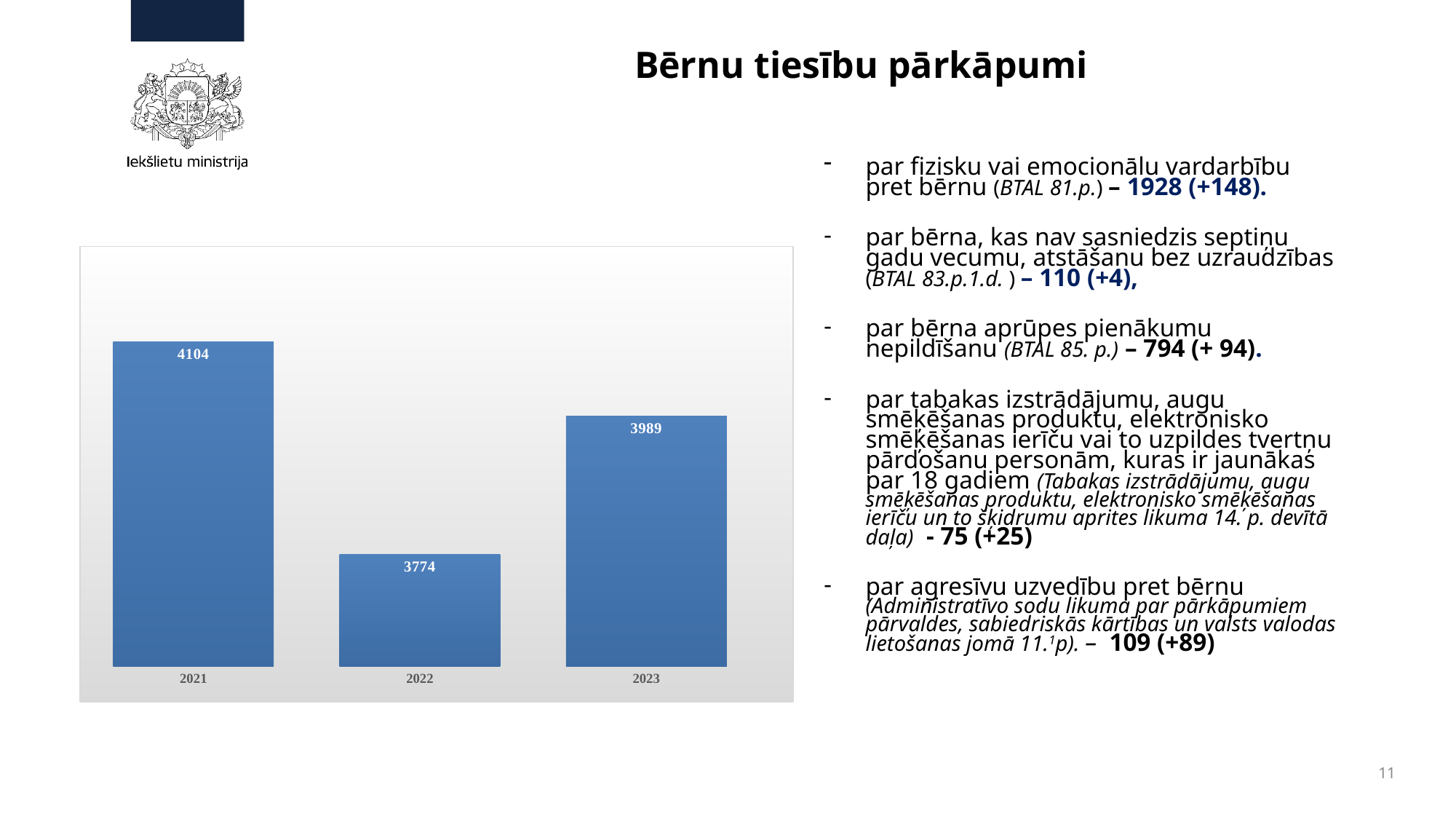
How many bars are shown in the chart? 3 Does the value rise or fall from 2021 to 2022? fall What is the difference between the values for 2021 and 2022? 330 Which year has the lowest value? 2022 What is the value for 2023? 3989 What is the difference between the values for 2023 and 2022? 215 Which year has the highest value? 2021 What kind of chart is shown on the slide? bar chart Which is larger, the value for 2021 or the value for 2023? 2021 What is the title of the slide containing the chart? Bērnu tiesību pārkāpumi What is the value for 2021? 4104 What is the value for 2022? 3774